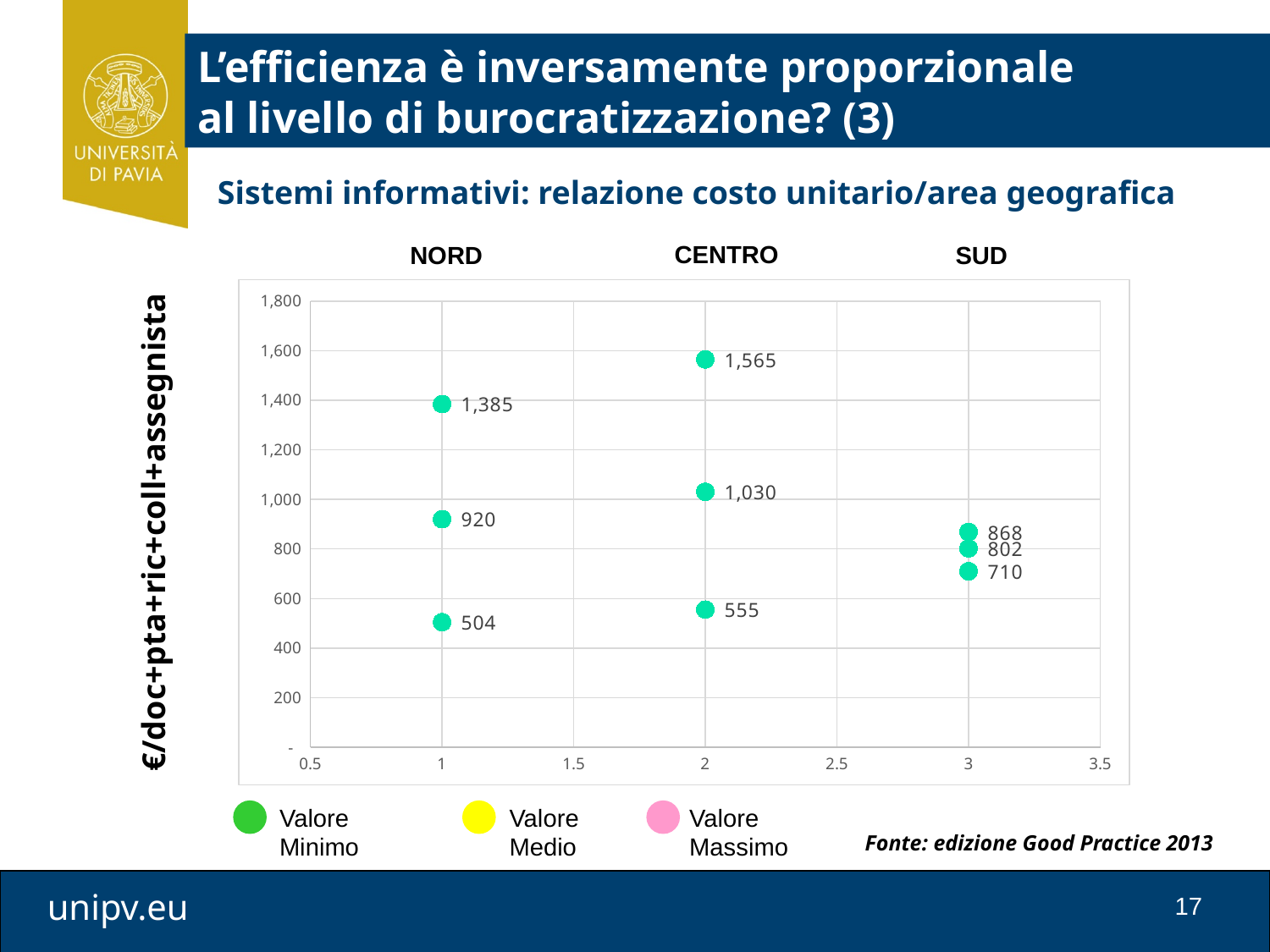
Which area has the highest plotted value overall? CENTRO What is the difference between the highest value for CENTRO and the highest value for NORD? 180 What is the highest value plotted for NORD? 1,385 What kind of chart is shown on the slide? Scatter chart What is the difference between the highest and lowest values plotted for SUD? 158 Which is larger, the middle value for NORD or the middle value for CENTRO? CENTRO How many entries does the legend list? 3 How many data points are plotted on the chart? 9 Which area has the lowest plotted value overall? NORD What is the lowest value plotted for CENTRO? 555 What is the middle value plotted for SUD? 802 What is the label of the vertical axis? €/doc+pta+ric+coll+assegnista